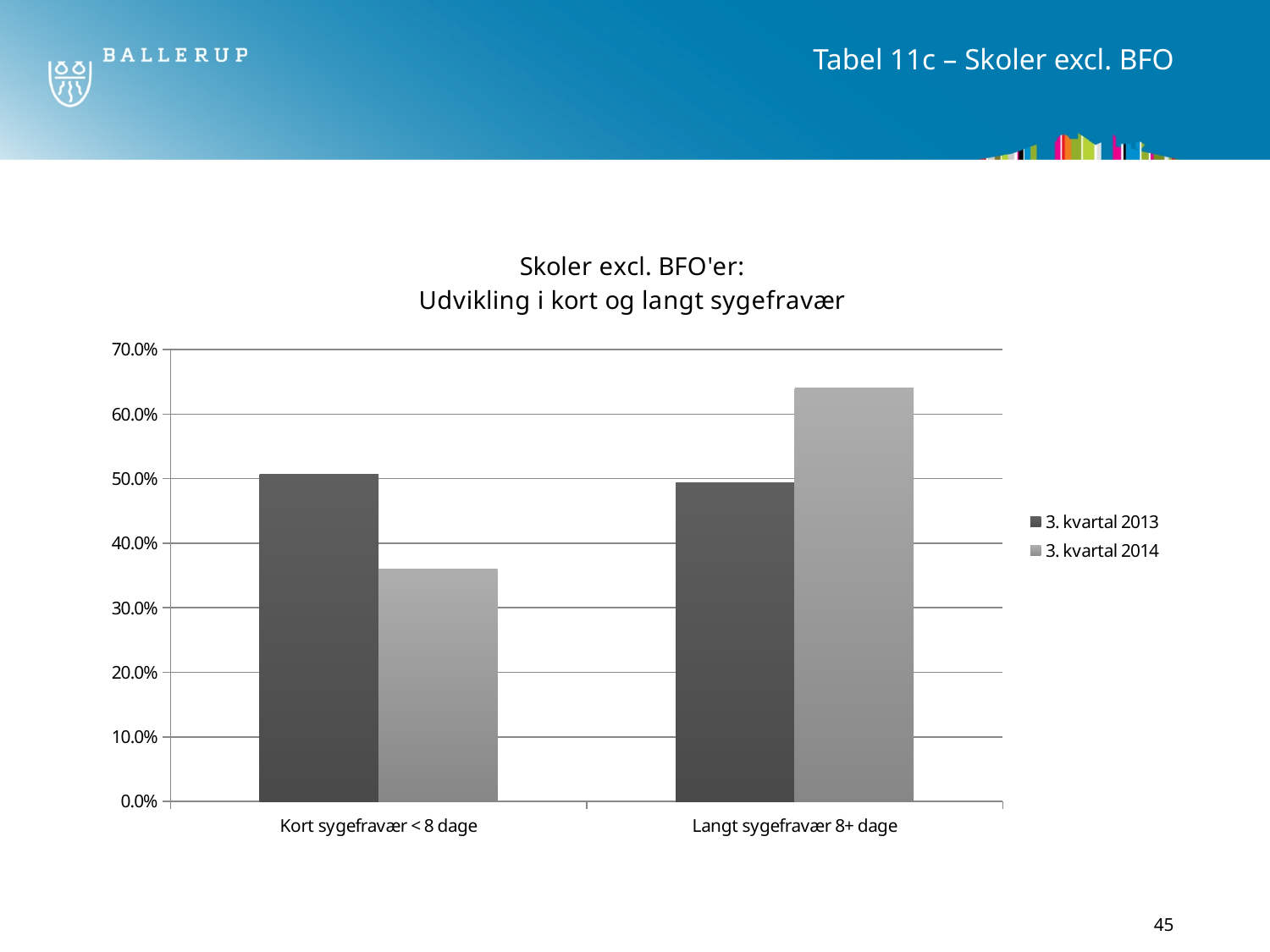
Which bar is the tallest in the chart? 3. kvartal 2014, Langt sygefravær 8+ dage What is the title of the chart? Skoler excl. BFO'er: Udvikling i kort og langt sygefravær What kind of chart is shown on the slide? bar chart Is the value for 3. kvartal 2014 in Kort sygefravær < 8 dage greater or less than 40.0%? less Which series is shown in the darker grey bars? 3. kvartal 2013 For Kort sygefravær < 8 dage, which series has the larger value, 3. kvartal 2013 or 3. kvartal 2014? 3. kvartal 2013 Is the value for 3. kvartal 2014 in Langt sygefravær 8+ dage greater or less than 60.0%? greater Is the value for 3. kvartal 2013 in Langt sygefravær 8+ dage greater or less than 40.0%? greater How many series does the legend list? 2 For Langt sygefravær 8+ dage, which series has the larger value, 3. kvartal 2013 or 3. kvartal 2014? 3. kvartal 2014 How many categories are shown on the x axis? 2